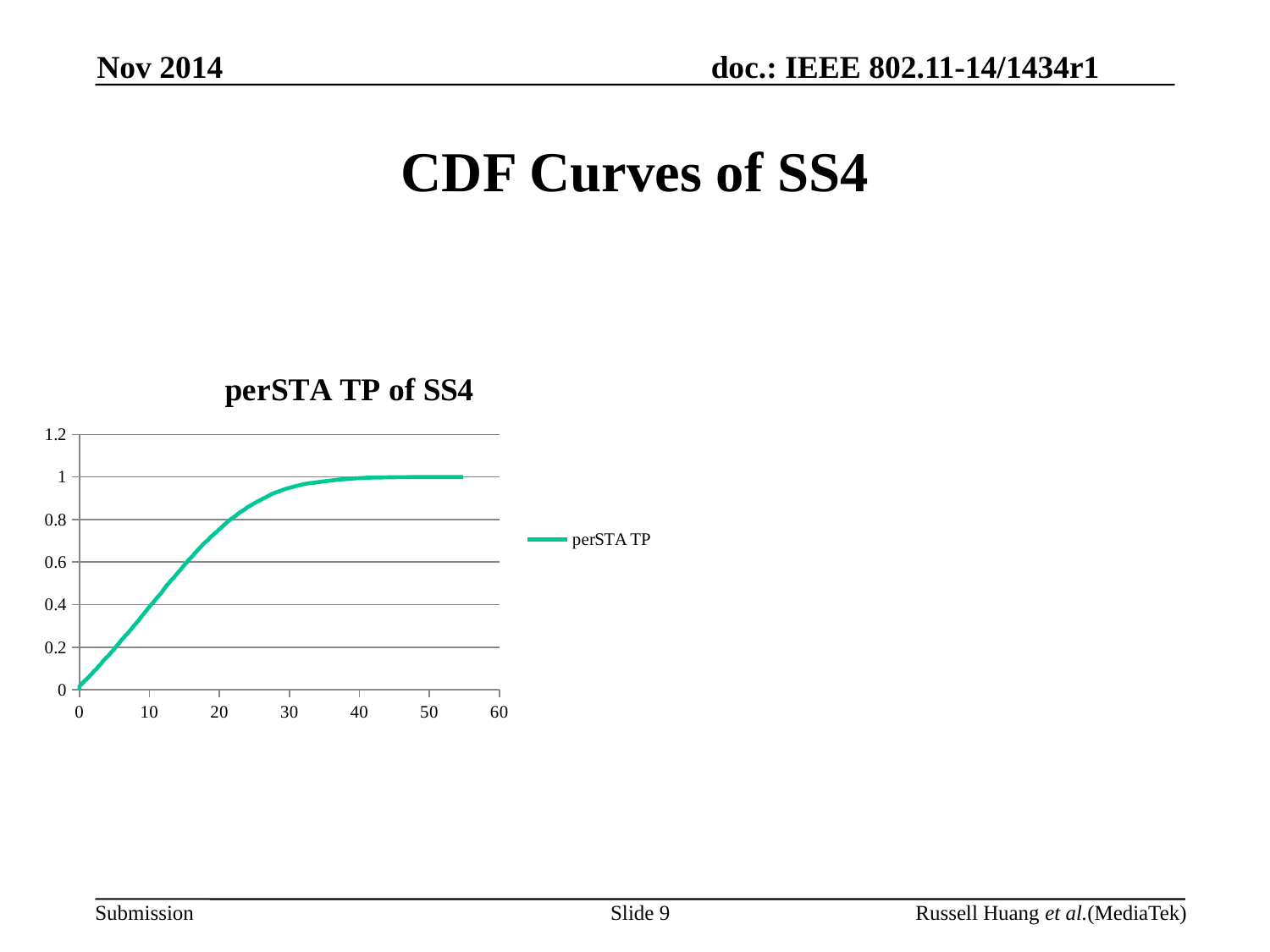
What is the title of the chart? perSTA TP of SS4 What kind of chart is shown on the slide? line chart Is the value of perSTA TP at x = 10 greater or less than 0.2? greater How many series does the legend list? 1 At what value does the perSTA TP curve level off for large x values? 1 Is the value of perSTA TP at x = 10 greater or less than 0.6? less Is the value of perSTA TP at x = 15 greater or less than 0.4? greater Which is larger, the perSTA TP value at x = 10 or at x = 30? x = 30 Does the perSTA TP curve rise or fall as the x-axis value increases? rise What is the name of the series shown in the legend? perSTA TP What is the value of the perSTA TP curve at x = 0? 0